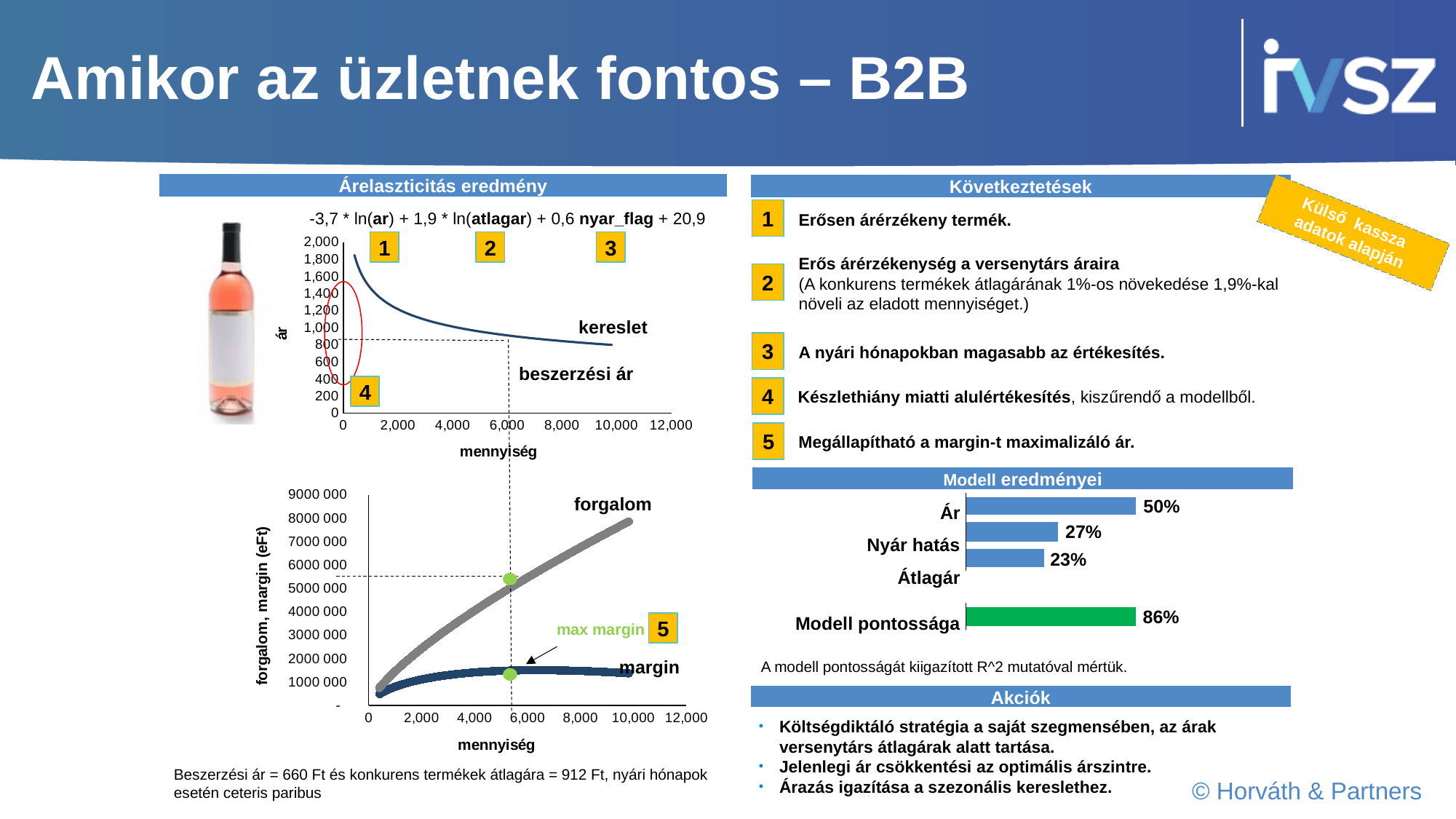
In the top-left chart under 'Árelaszticitás eredmény', does the kereslet curve rise or fall as mennyiség increases? fall In the 'Modell eredményei' bar chart, what is the value for Modell pontossága? 86% What kind of chart is the 'Modell eredményei' chart? bar chart In the 'Modell eredményei' bar chart, which of Ár, Nyár hatás and Átlagár has the lowest value? Átlagár In the 'Modell eredményei' bar chart, which is larger: Nyár hatás or Átlagár? Nyár hatás In the 'Modell eredményei' bar chart, what is the value for Nyár hatás? 27% How many bars are shown in the 'Modell eredményei' chart? 4 In the top-left chart, is the kereslet value at 10,000 mennyiség greater or less than 1,000? less In the bottom-left chart, is the value of margin at 10,000 mennyiség greater or less than 2000 000? less In the 'Modell eredményei' bar chart, what is the difference between the values for Ár and Nyár hatás? 23% In the 'Modell eredményei' bar chart, what is the value for Ár? 50% In the bottom-left chart, does the forgalom curve rise or fall as mennyiség increases? rise